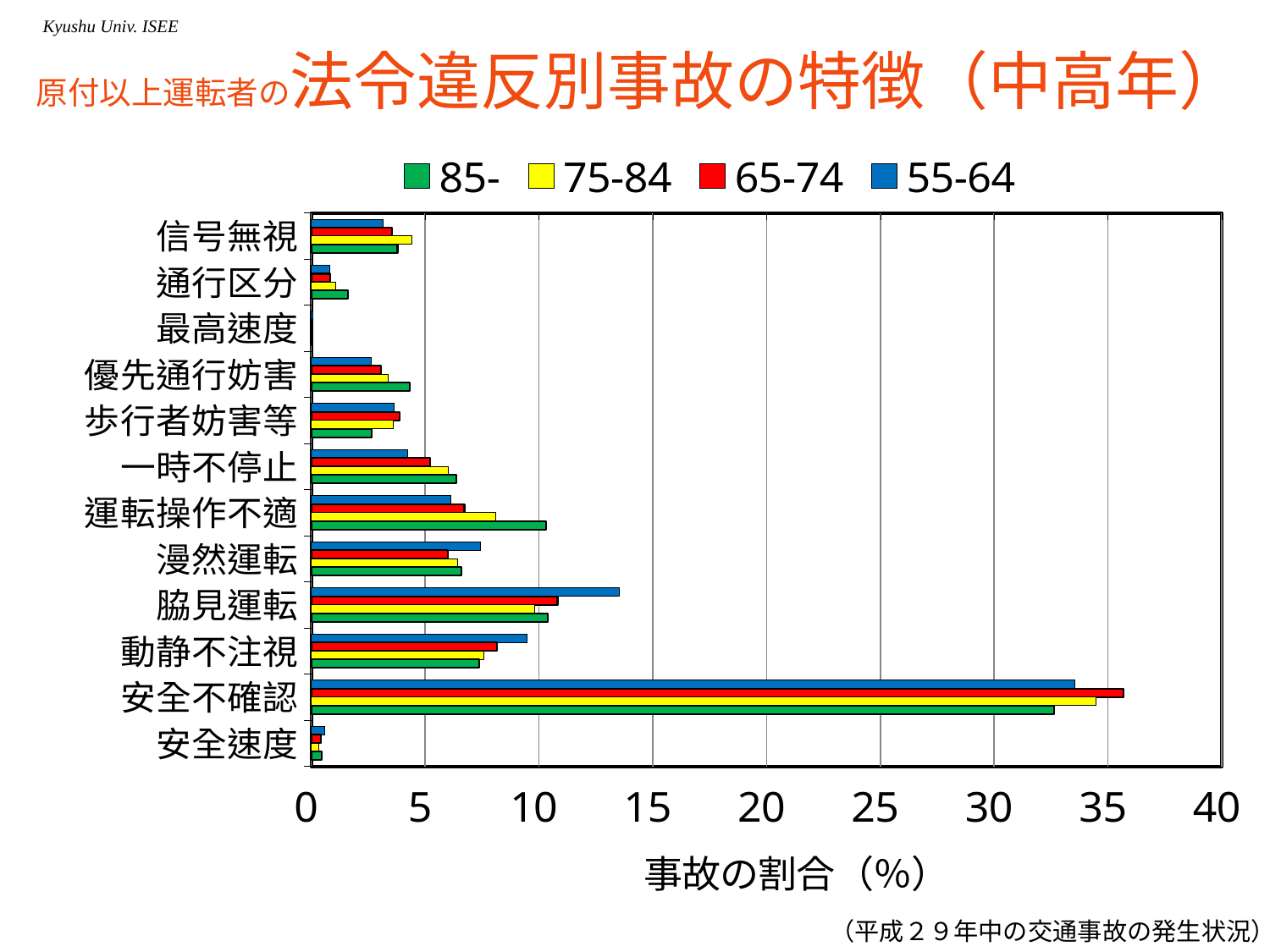
Is the value for 一時不停止 in the 85- series greater or less than 5? greater Is the value for 信号無視 in the 85- series greater or less than 5? less Which category has the lowest values across all series? 最高速度 How many violation categories are plotted on the y axis? 12 How many series does the legend list? 4 For 脇見運転, which series has the larger value: 55-64 or 85-? 55-64 Which category has the highest value for the 55-64 series? 安全不確認 Is the value for 脇見運転 in the 55-64 series greater or less than 10? greater What is the title of the x axis? 事故の割合（%） For 運転操作不適, which series has the larger value: 85- or 55-64? 85- What kind of chart is shown on the slide? bar chart